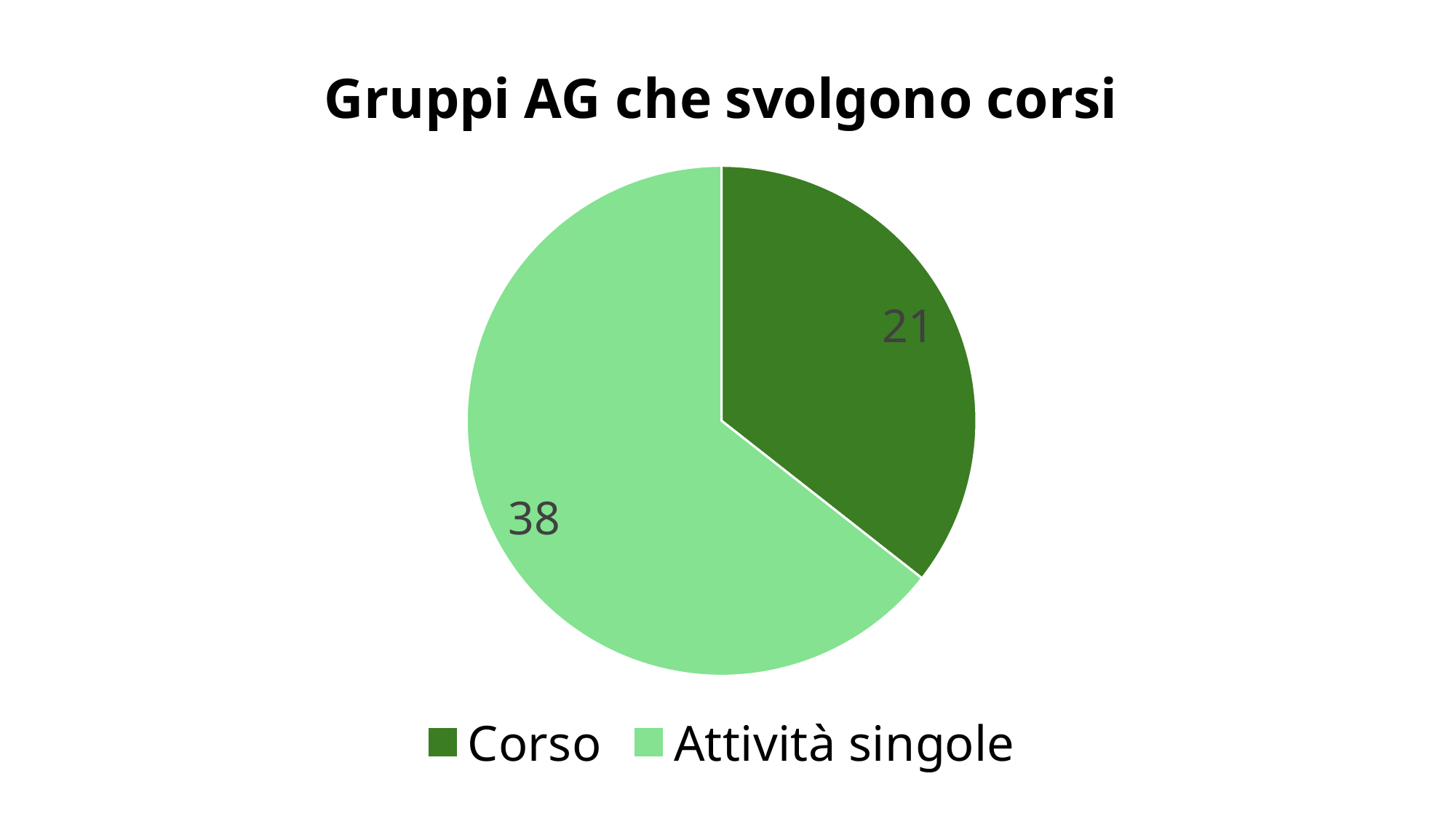
What kind of chart is shown on the slide? Pie chart What is the total of the two slices? 59 What is the value for Corso? 21 How many slices does the pie chart have? 2 What is the difference between the values for Attività singole and Corso? 17 Which category has the smallest slice? Corso What is the title of the chart? Gruppi AG che svolgono corsi Which category is shown in dark green? Corso Which category has the largest slice? Attività singole What is the value for Attività singole? 38 Which is larger, Corso or Attività singole? Attività singole